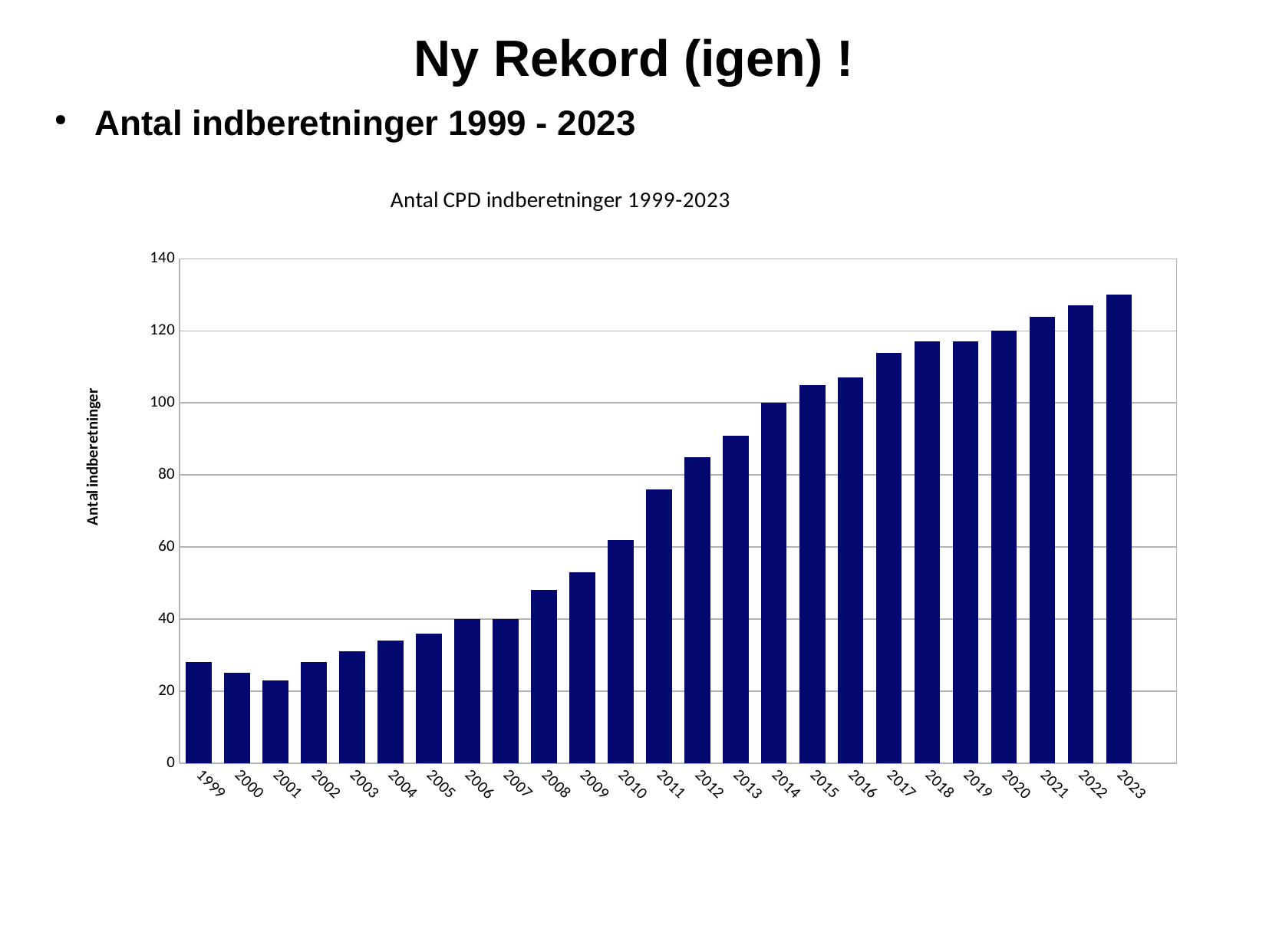
How many years (bars) are shown in the chart? 25 What kind of chart is shown on the slide? bar chart What is the title of the chart? Antal CPD indberetninger 1999-2023 Which year has the highest number of indberetninger? 2023 Is the value for 2023 greater or less than 120? greater Is the value for 2012 greater or less than 80? greater Do the values generally rise or fall from 1999 to 2023? rise Which year has the larger value, 2010 or 2015? 2015 Which year has the lowest number of indberetninger? 2001 Is the value for 2001 greater or less than 40? less What is the label on the vertical axis of the chart? Antal indberetninger